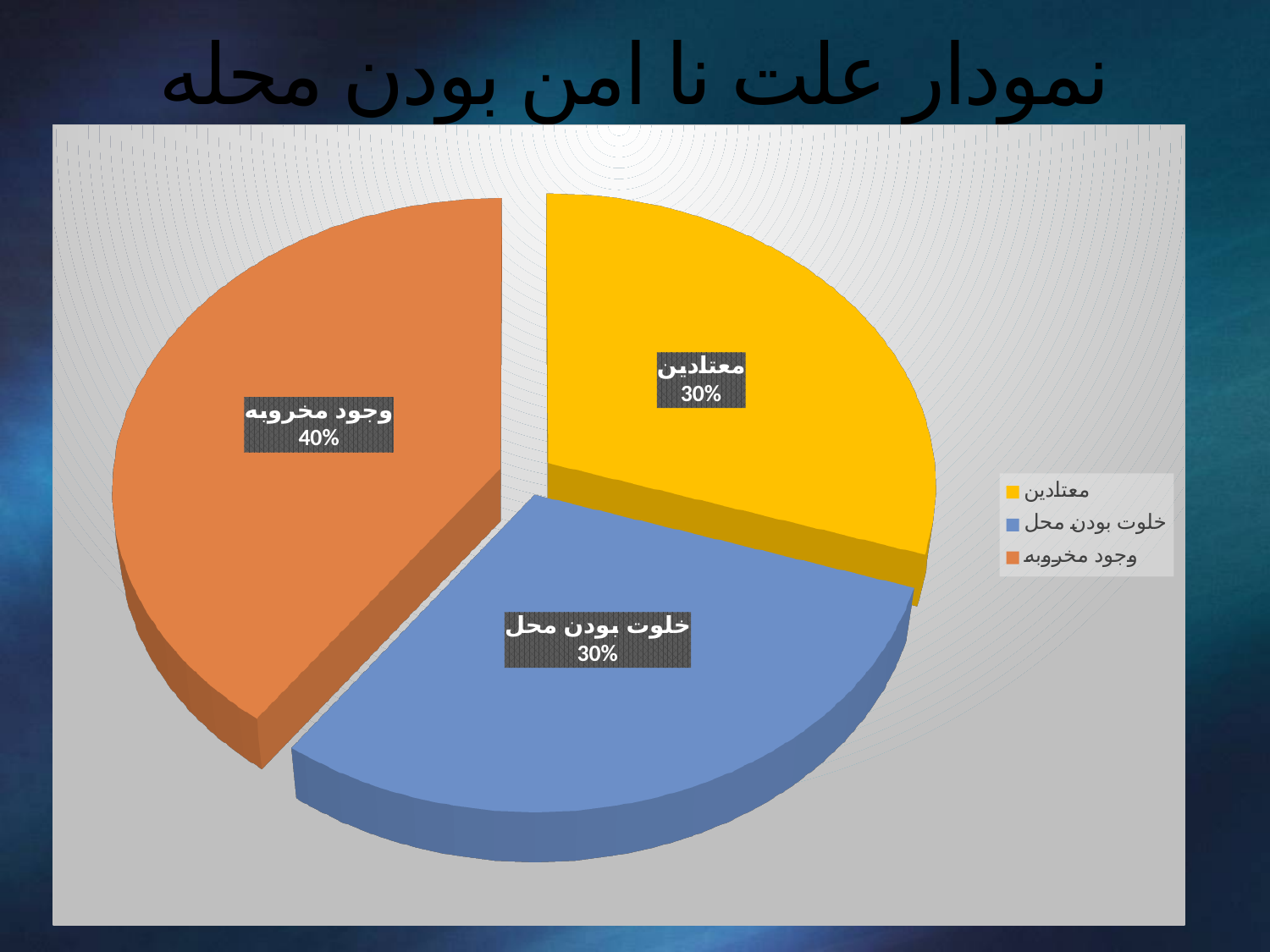
How many slices does the pie chart have? 3 What colour is the slice for خلوت بودن محل? blue Which category has the largest slice of the pie? وجود مخروبه What is the value shown for معتادین? 30% What kind of chart is shown on the slide? pie chart Which is larger, the slice for وجود مخروبه or the slice for معتادین? وجود مخروبه What is the difference in percentage points between وجود مخروبه and خلوت بودن محل? 10 percentage points How many entries does the legend list? 3 What is the title of the chart? نمودار علت نا امن بودن محله What is the value shown for خلوت بودن محل? 30% What share of the pie does وجود مخروبه represent? 40%